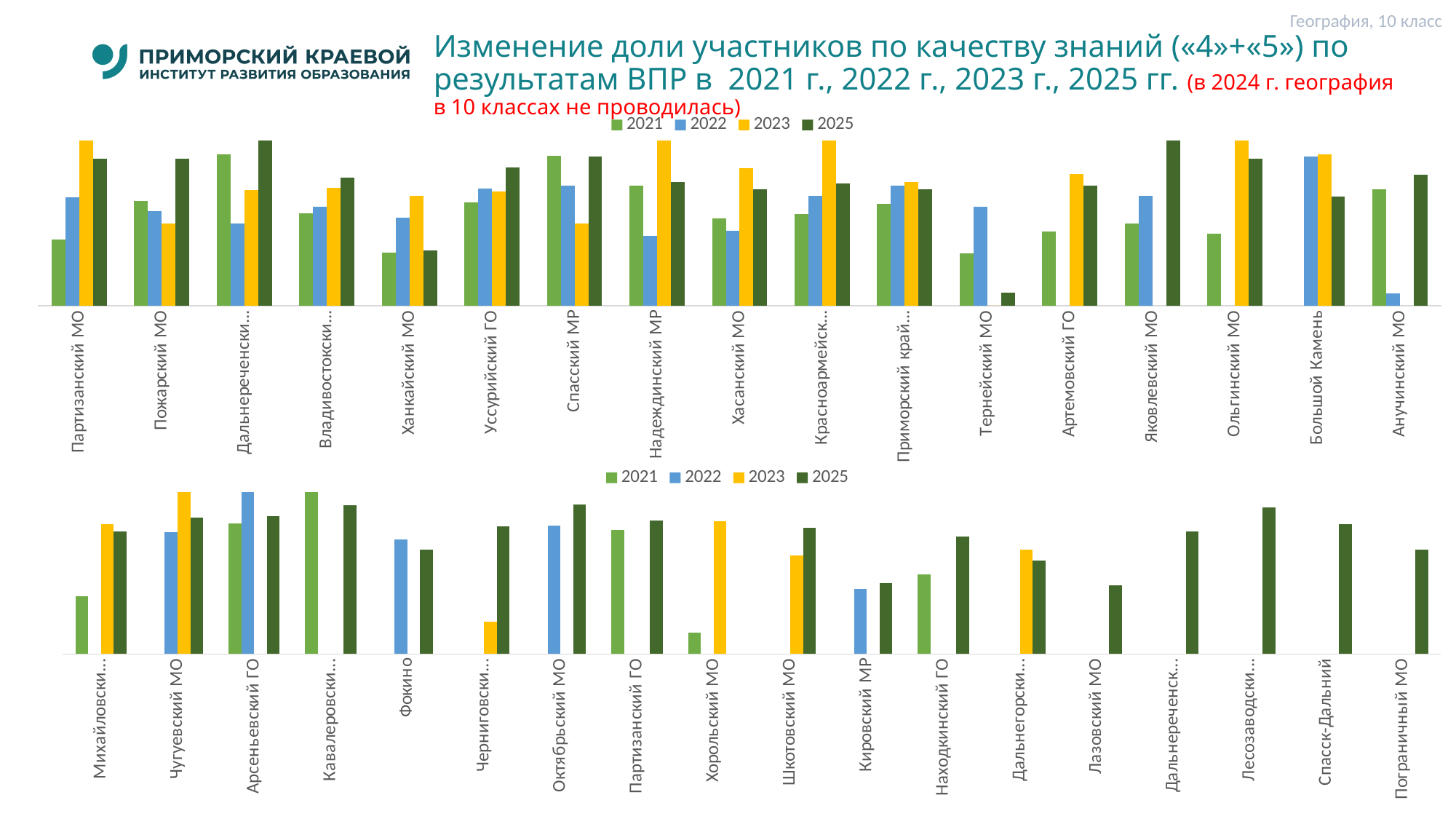
In the top chart, which year has the tallest bar for Партизанский МО? 2023 In the top chart, for Ханкайский МО, is the 2023 bar or the 2021 bar taller? 2023 In the top chart, which year has the shortest bar for Тернейский МО? 2025 In the bottom chart, for Фокино, is the 2022 bar or the 2025 bar taller? 2022 In the bottom chart, for Хорольский МО, is the 2021 bar or the 2023 bar taller? 2023 How many series does the legend of the top chart list? 4 How many categories are shown on the x axis of the top chart? 17 In the top chart, which year has the shortest bar for Анучинский МО? 2022 What kind of chart is the top chart on the slide? bar chart How many categories are shown on the x axis of the bottom chart? 18 Which years are listed in the legend of the bottom chart? 2021, 2022, 2023, 2025 In the bottom chart, which year has the tallest bar for Арсеньевский ГО? 2022